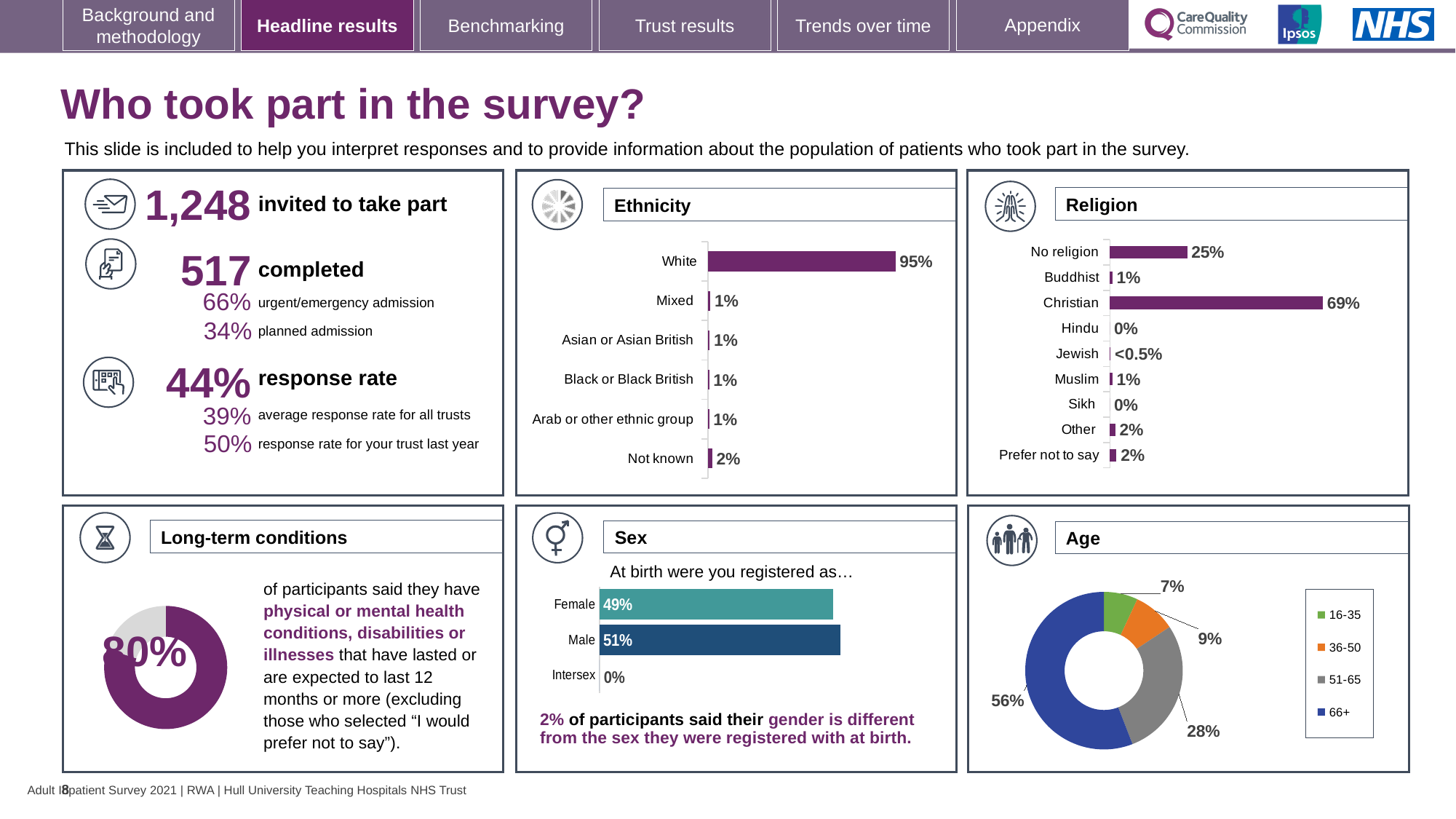
In the Ethnicity chart, what is the value for Not known? 2% In the Religion chart, what is the value for No religion? 25% In the Religion chart, which religion category has the highest value? Christian In the Religion chart, what is the difference between Christian and No religion? 44% How many categories are shown in the Religion chart? 9 In the Sex chart, which is larger, Female or Male? Male How many ethnicity categories are shown in the Ethnicity chart? 6 How many age groups does the legend of the Age chart list? 4 In the Sex chart, what is the value for Female? 49% In the Ethnicity chart, what percentage of participants were White? 95% What kind of chart is used in the Age panel? Donut (pie) chart In the Age chart, what share of participants were aged 66+? 56%